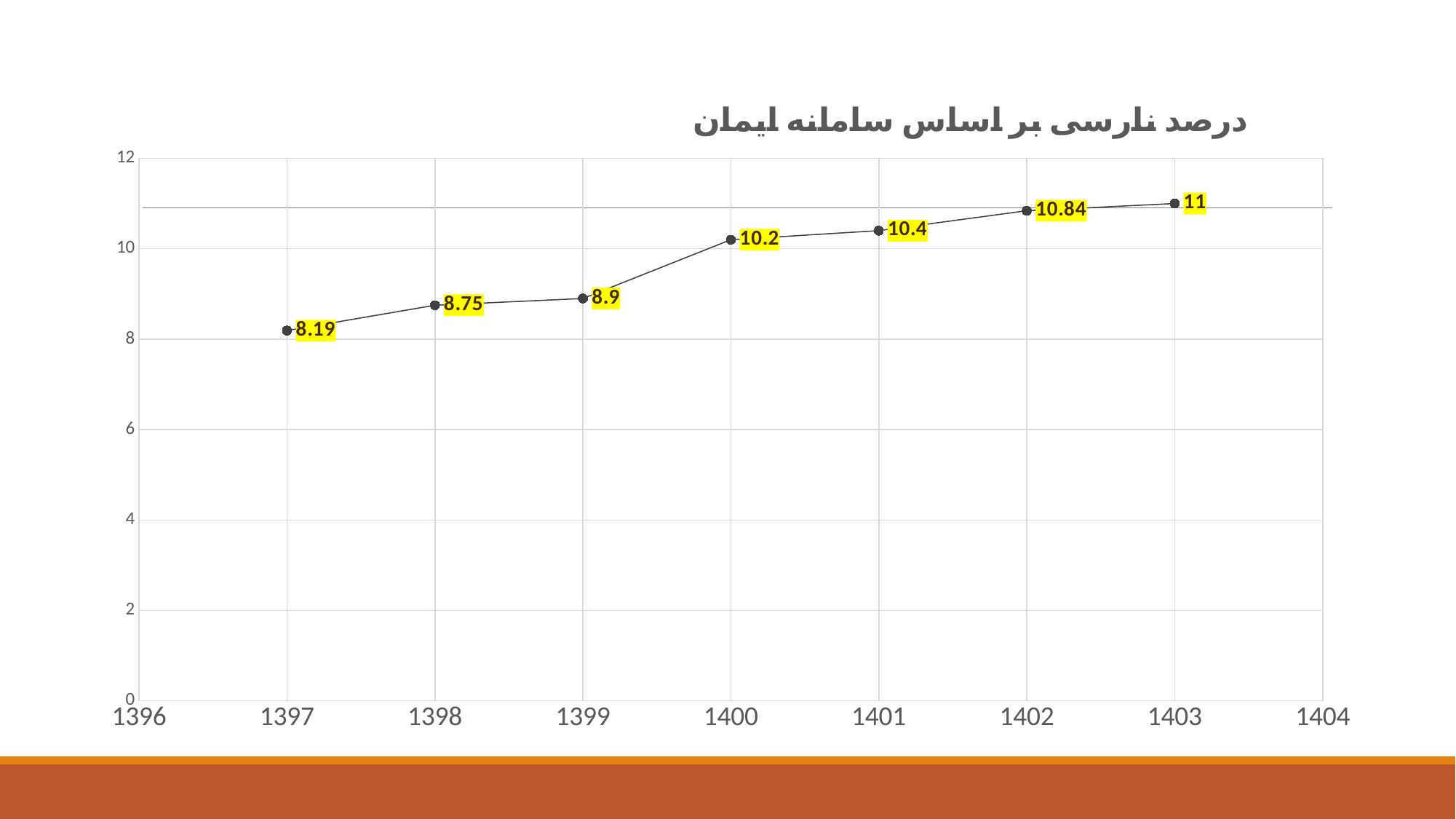
Do the values rise or fall from 1397 to 1403? Rise What is the value for 1397? 8.19 Which year has the lowest value? 1397 What is the value for 1403? 11 What is the value for 1402? 10.84 Which is larger, the value for 1398 or the value for 1401? 1401 Which year has the highest value? 1403 How many data points are plotted on the chart? 7 What is the difference between the values for 1403 and 1397? 2.81 What is the value for 1400? 10.2 What kind of chart is shown on the slide? Line chart What is the difference between the values for 1400 and 1399? 1.3